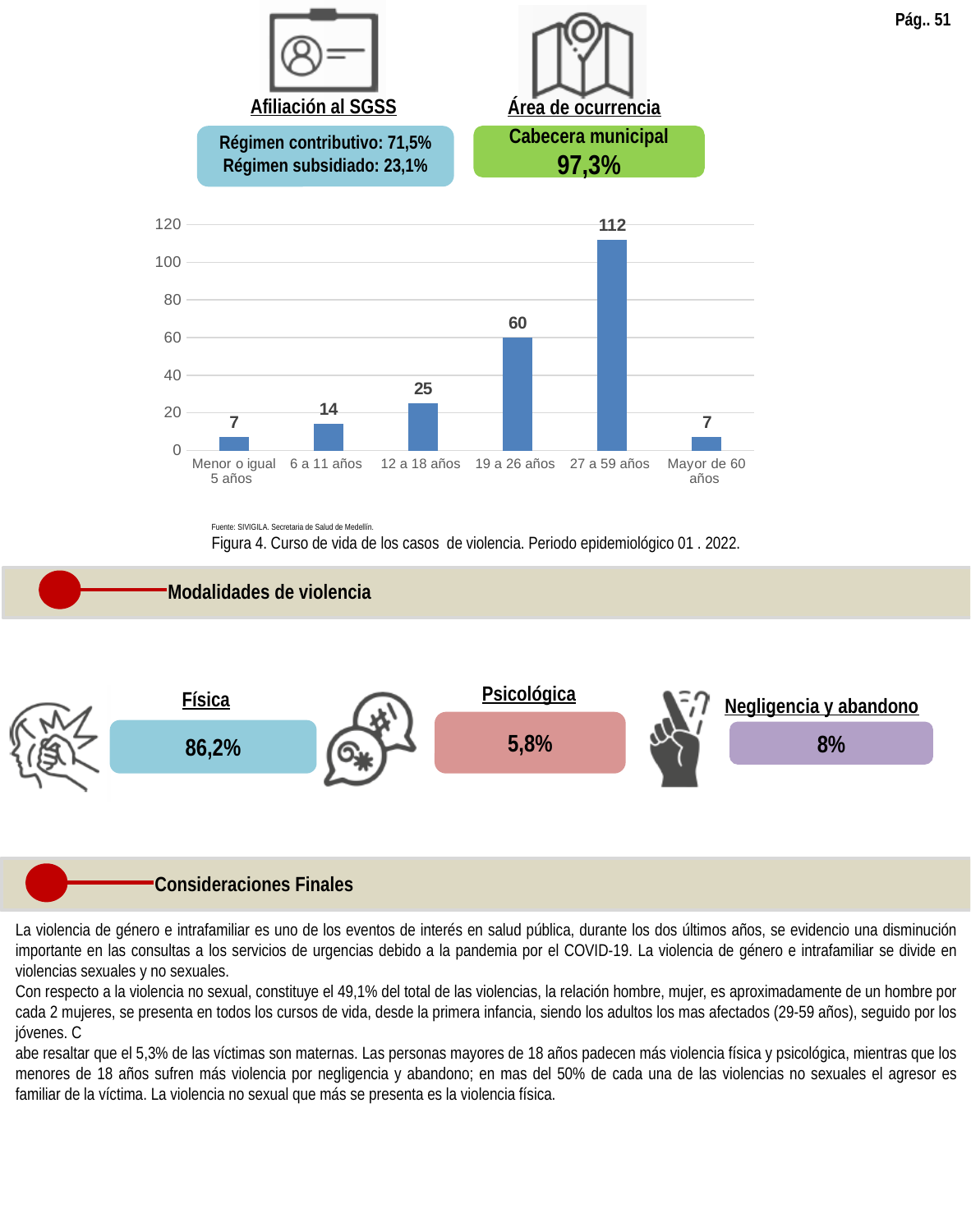
What is the value for the 'Mayor de 60 años' category in the bar chart? 7 What is the value for the '12 a 18 años' category in the bar chart? 25 What is the caption of the bar chart (Figura 4)? Figura 4. Curso de vida de los casos de violencia. Periodo epidemiológico 01 . 2022. What is the difference between the values for '19 a 26 años' and '6 a 11 años'? 46 What kind of chart is shown on the slide? bar chart Which category has the highest value in the bar chart? 27 a 59 años What is the difference between the values for '27 a 59 años' and '19 a 26 años'? 52 Is the value for '27 a 59 años' greater or less than 100? greater How many categories are shown on the x axis of the bar chart? 6 Which is larger, the value for '19 a 26 años' or the value for '12 a 18 años'? 19 a 26 años What is the value for the '6 a 11 años' category in the bar chart? 14 What is the value for the '27 a 59 años' category in the bar chart? 112